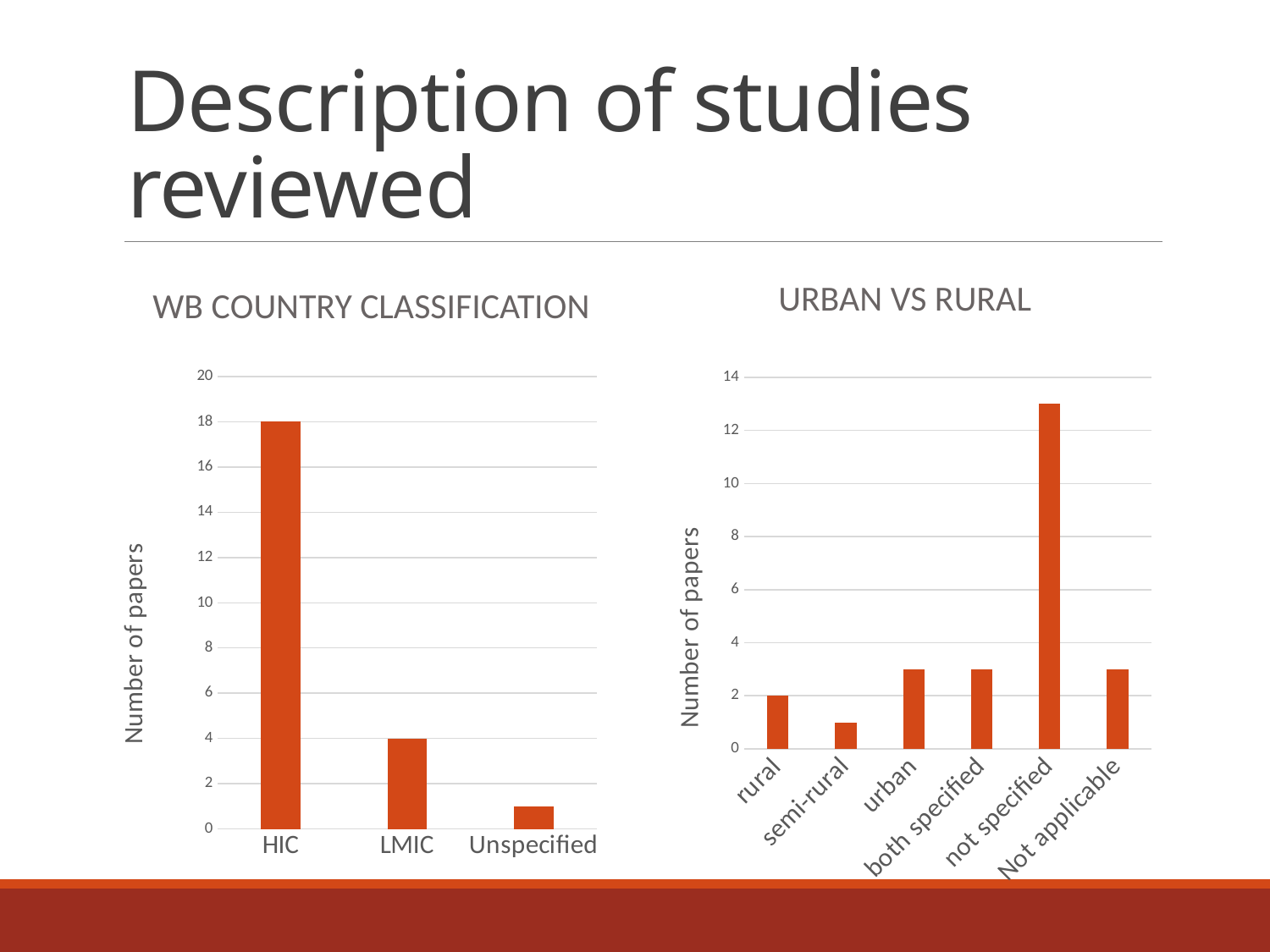
In the Urban vs Rural chart, which category has the lowest number of papers? semi-rural In the WB Country Classification chart, which category has the lowest number of papers? Unspecified In the WB Country Classification chart, is the value for Unspecified greater or less than 2? less In the Urban vs Rural chart, which category has the highest number of papers? not specified In the Urban vs Rural chart, what is the number of papers for rural? 2 In the Urban vs Rural chart, is the value for not specified greater or less than 12? greater In the WB Country Classification chart, which category has the highest number of papers? HIC In the Urban vs Rural chart, how many categories are shown on the x axis? 6 In the WB Country Classification chart, what is the number of papers for LMIC? 4 In the WB Country Classification chart, how many categories are shown on the x axis? 3 In the WB Country Classification chart, what is the difference in number of papers between HIC and LMIC? 14 In the WB Country Classification chart, what is the number of papers for HIC? 18